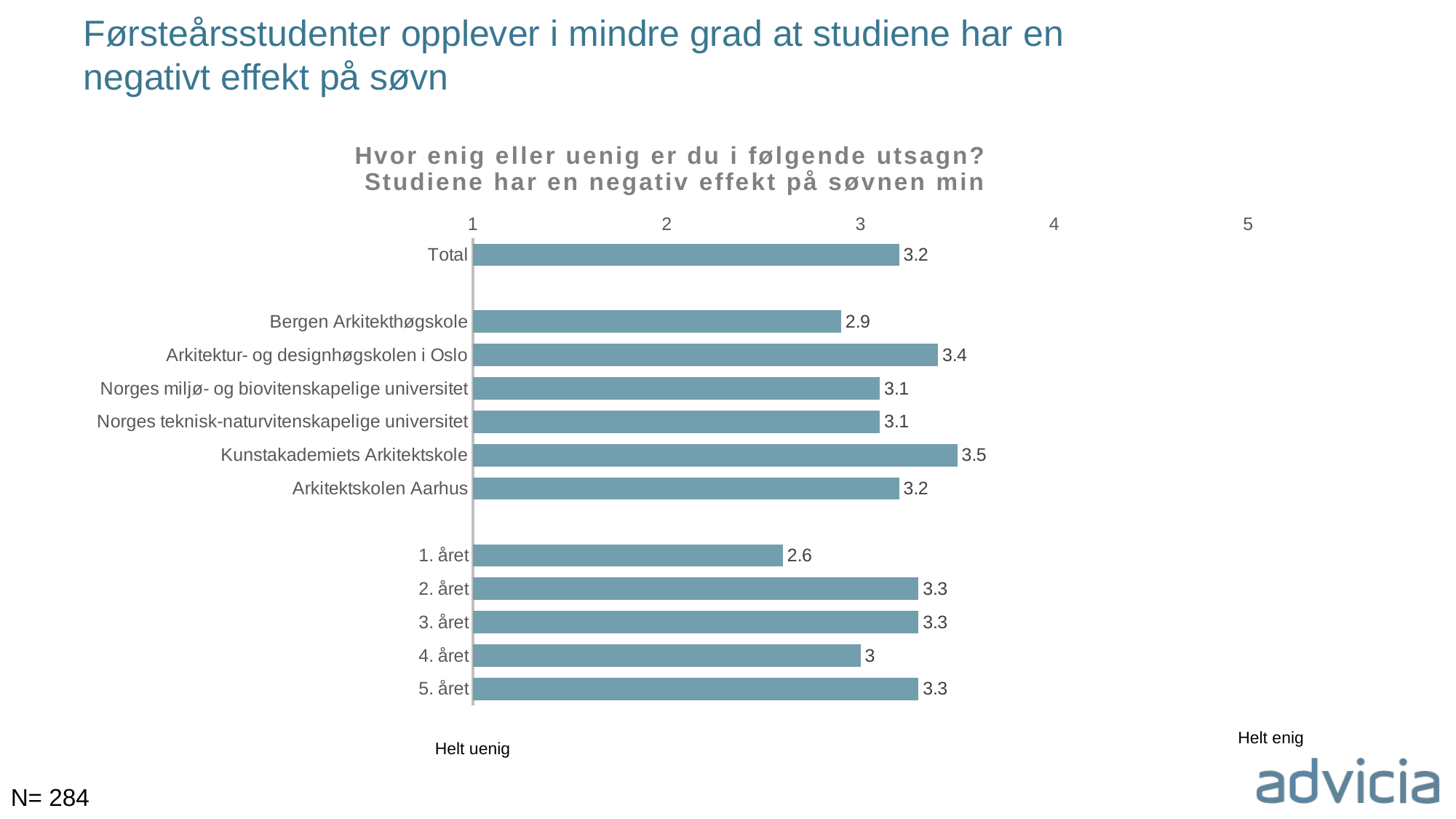
Which category has the highest value? Kunstakademiets Arkitektskole What is the difference between the values for Kunstakademiets Arkitektskole and Bergen Arkitekthøgskole? 0.6 How many categories are plotted in the chart? 12 What is the chart's title? Hvor enig eller uenig er du i følgende utsagn? Studiene har en negativ effekt på søvnen min What is the value for 4. året? 3 What is the value for Total? 3.2 Which is larger, the value for Arkitektur- og designhøgskolen i Oslo or the value for Arkitektskolen Aarhus? Arkitektur- og designhøgskolen i Oslo What kind of chart is shown on the slide? bar chart What is the value for Bergen Arkitekthøgskole? 2.9 Is the value for 1. året greater or less than 3? less Which category has the lowest value? 1. året What is the value for 1. året? 2.6